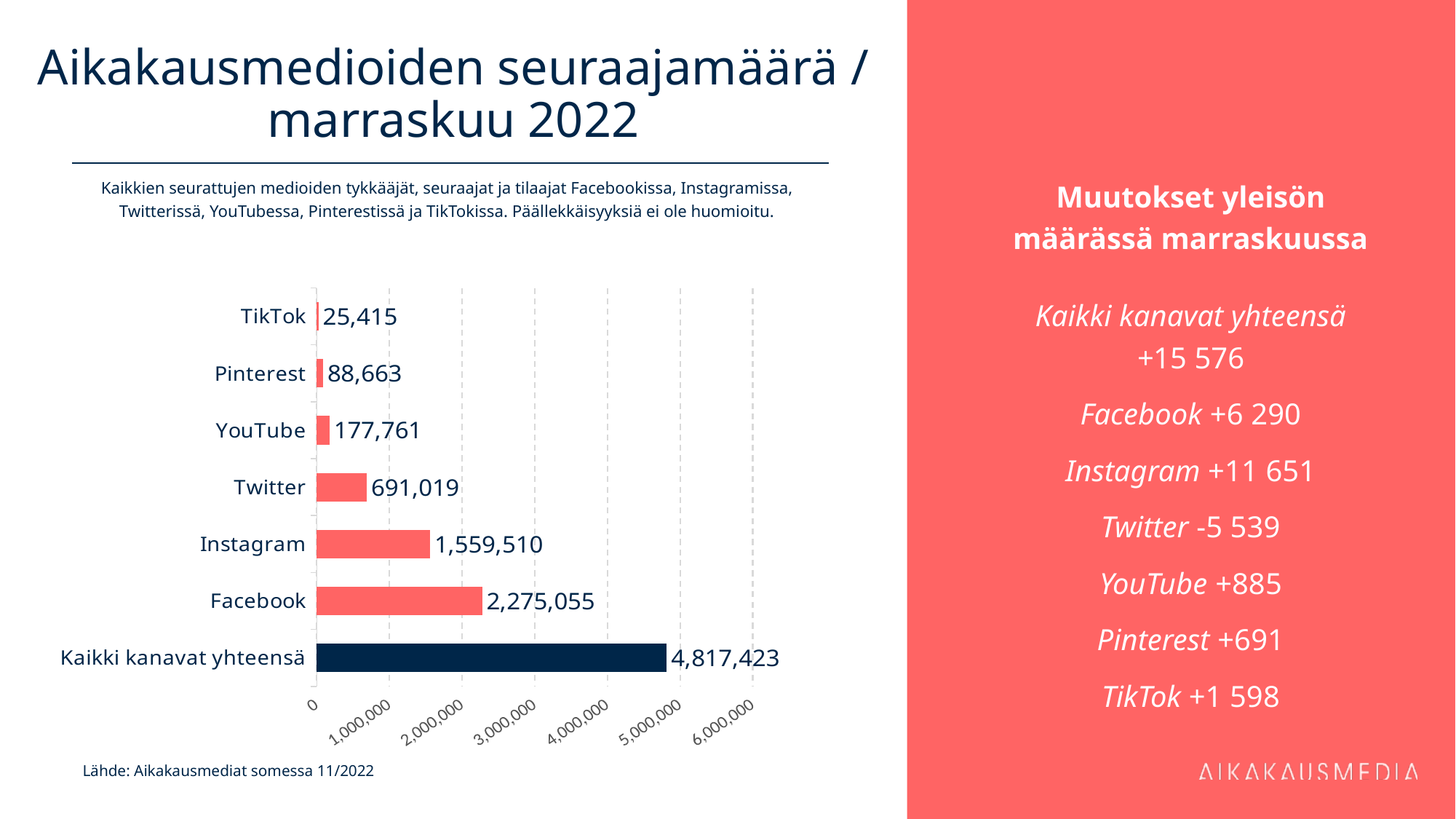
What is the difference between the Facebook and Instagram values? 715,545 What is the value shown for Kaikki kanavat yhteensä? 4,817,423 What is the value shown for Facebook? 2,275,055 Which category has the lowest value? TikTok What kind of chart is shown on the slide? Bar chart What is the value shown for TikTok? 25,415 What is the difference between the Twitter and YouTube values? 513,258 Which individual channel (excluding the total) has the highest value? Facebook How many categories are shown in the chart? 7 Is the value for Instagram greater or less than 1,000,000? greater Which is larger, the value for Twitter or the value for Pinterest? Twitter What is the value shown for YouTube? 177,761